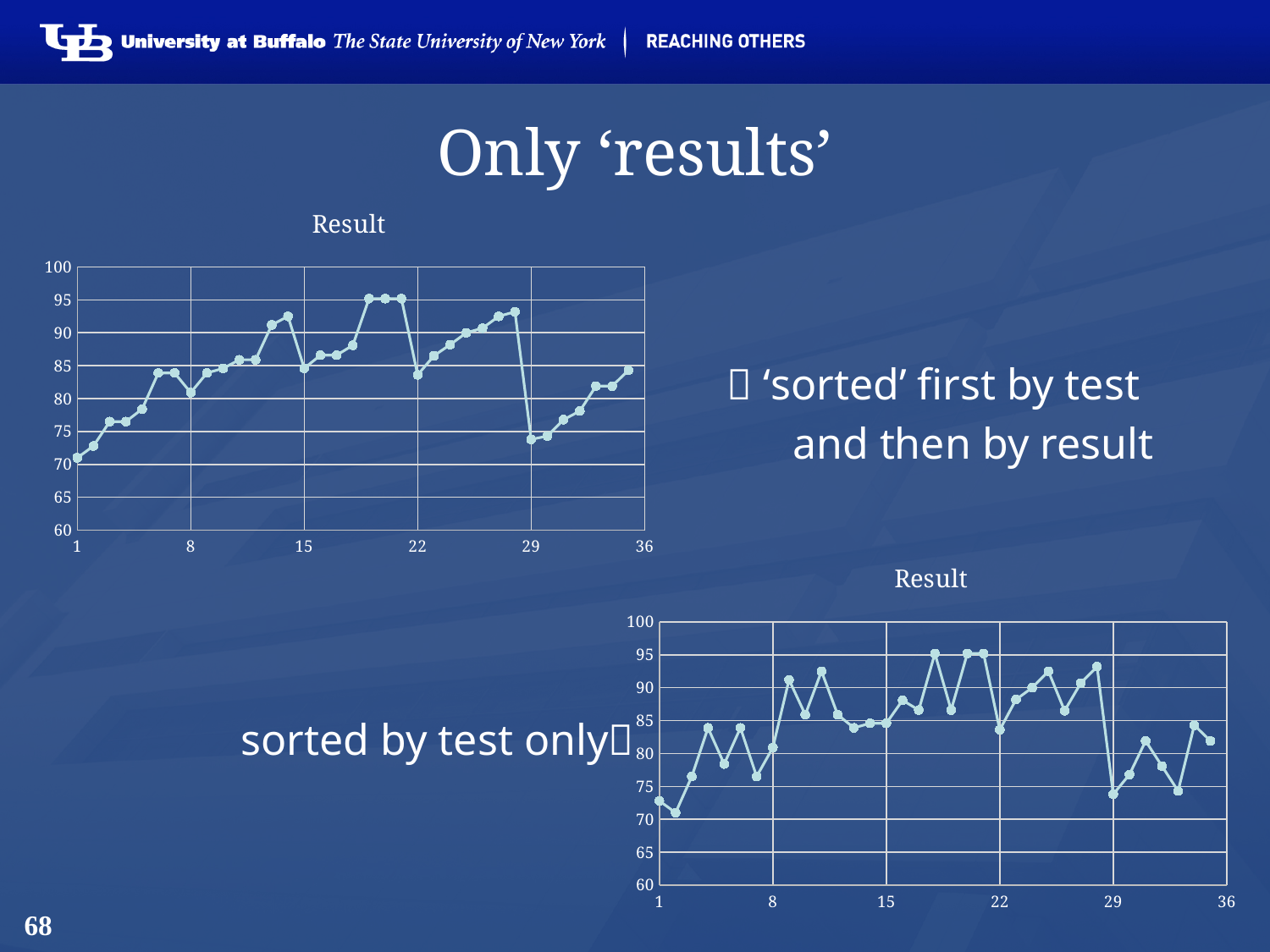
What kind of chart is the top-left chart titled 'Result'? line chart What is the title of the top-left chart? Result In the top-left chart, do the values rise or fall from x = 29 to x = 36? rise How many charts are shown on the slide? 2 What kind of chart is the bottom-right chart titled 'Result'? line chart In the bottom-right chart, is the value at x = 29 greater or less than 80? less In the top-left chart, is the value at x = 22 greater or less than 80? greater What is the highest value shown on the y axis of the bottom-right chart? 100 In the top-left chart, is the value at x = 1 greater or less than 75? less